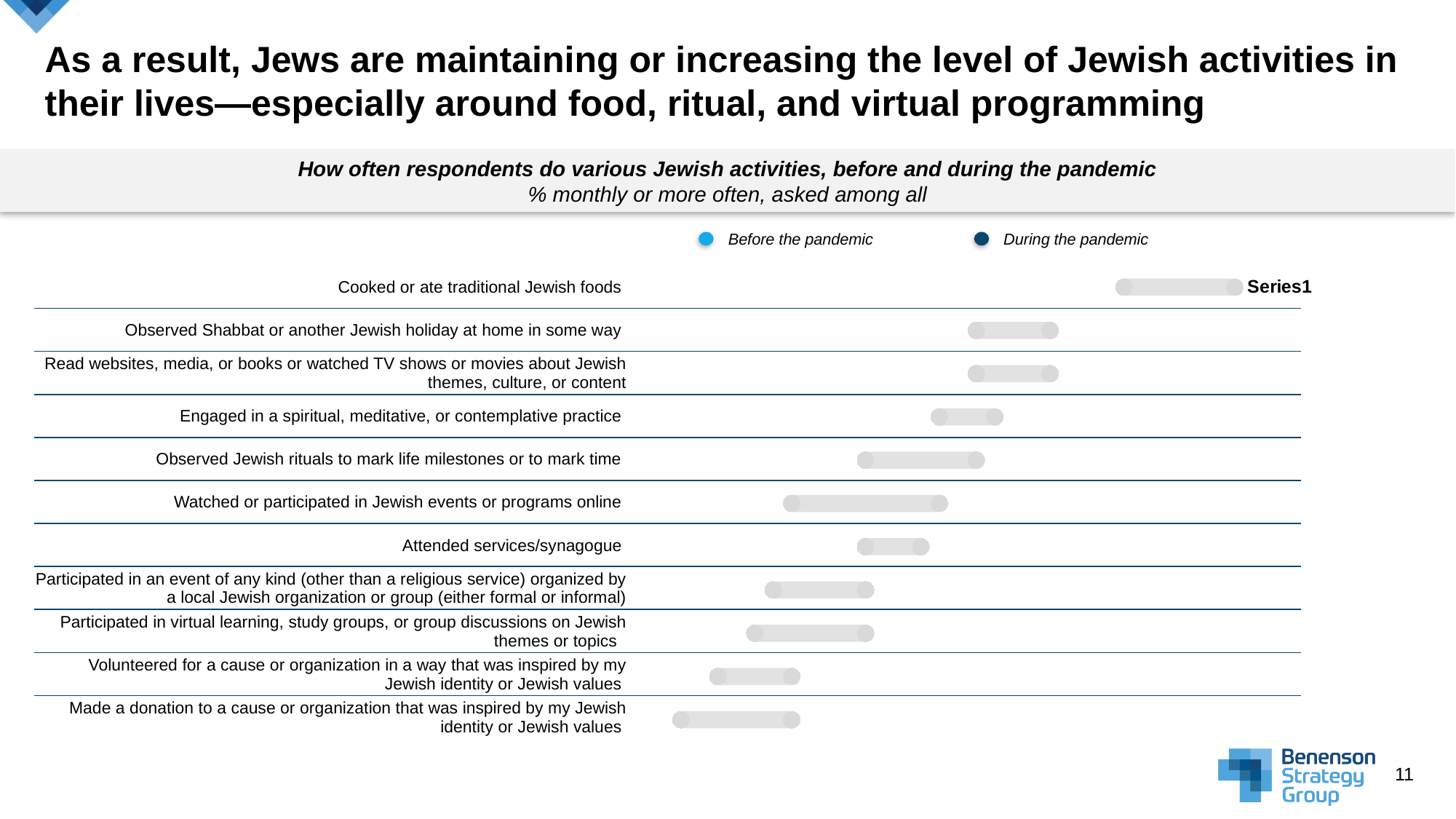
Which bar is positioned further to the right: 'Observed Shabbat or another Jewish holiday at home in some way' or 'Volunteered for a cause or organization in a way that was inspired by my Jewish identity or Jewish values'? Observed Shabbat or another Jewish holiday at home in some way How many Jewish activities (categories) are listed in the chart? 11 What is the title of the chart? How often respondents do various Jewish activities, before and during the pandemic How many series does the chart legend list? 2 What kind of chart is shown on the slide? bar chart Which activity's bar extends furthest to the right in the chart? Cooked or ate traditional Jewish foods Which activity's bar sits furthest to the left in the chart? Made a donation to a cause or organization that was inspired by my Jewish identity or Jewish values What are the two series named in the chart legend? Before the pandemic; During the pandemic Which bar is positioned further to the right: 'Cooked or ate traditional Jewish foods' or 'Attended services/synagogue'? Cooked or ate traditional Jewish foods